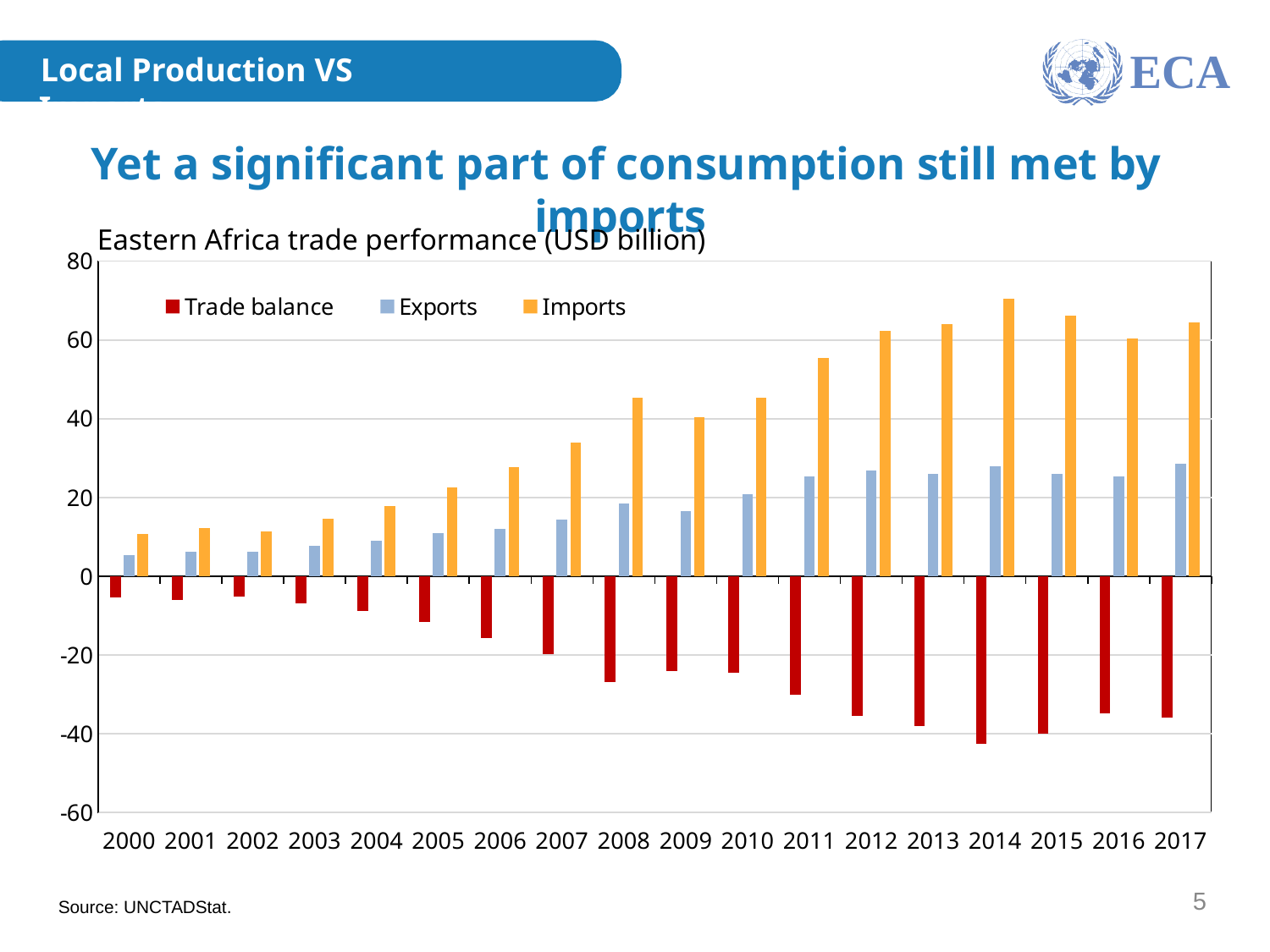
In which year is the Trade balance most negative? 2014 In which year are Exports lowest? 2000 Is the value for Trade balance in 2014 greater or less than -20? less Is the value for Exports in 2012 greater or less than 20? greater Is the value for Imports in 2014 greater or less than 60? greater In which year are Imports highest? 2014 Do Imports generally rise or fall from 2000 to 2017? Rise How many years are shown on the x axis? 18 Which is larger, Imports in 2014 or Imports in 2016? Imports in 2014 How many series does the legend list? 3 What kind of chart is shown on the slide? Bar chart What is the title of the chart? Eastern Africa trade performance (USD billion)